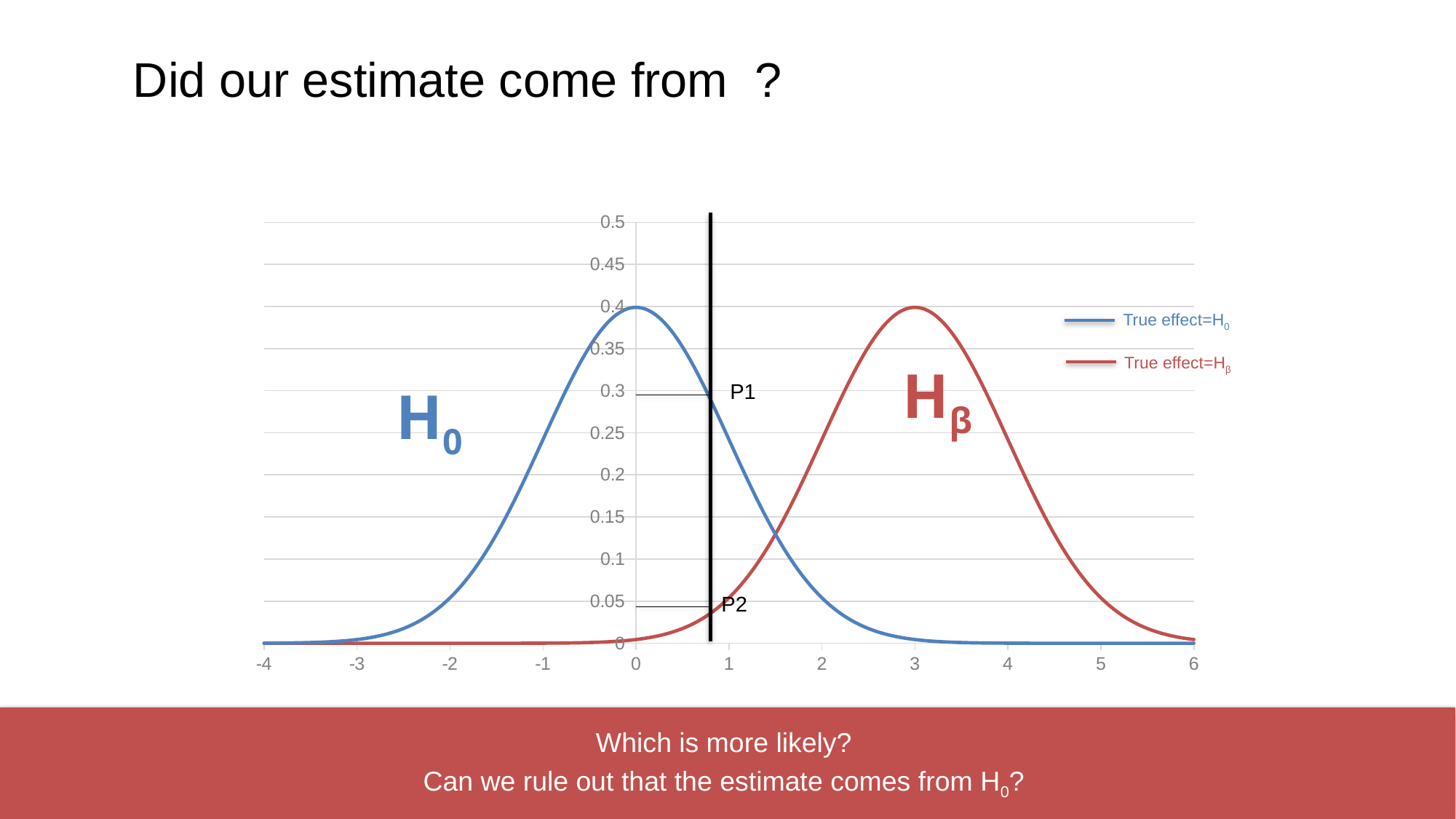
At the vertical black line, which curve has the higher value, True effect=H0 or True effect=Hβ? True effect=H0 Is the value at P1 greater or less than 0.2? greater What is the highest value shown on the y axis? 0.5 What kind of chart is shown on the slide? line chart What are the two legend entries? True effect=H0 and True effect=Hβ At which x-axis value does the True effect=H0 curve reach its peak? 0 What colour is the curve for True effect=Hβ? red Is the value at P2 greater or less than 0.1? less Is the value of the True effect=Hβ curve at x = 0 greater or less than 0.05? less How many series does the legend list? 2 At which x-axis value does the True effect=Hβ curve reach its peak? 3